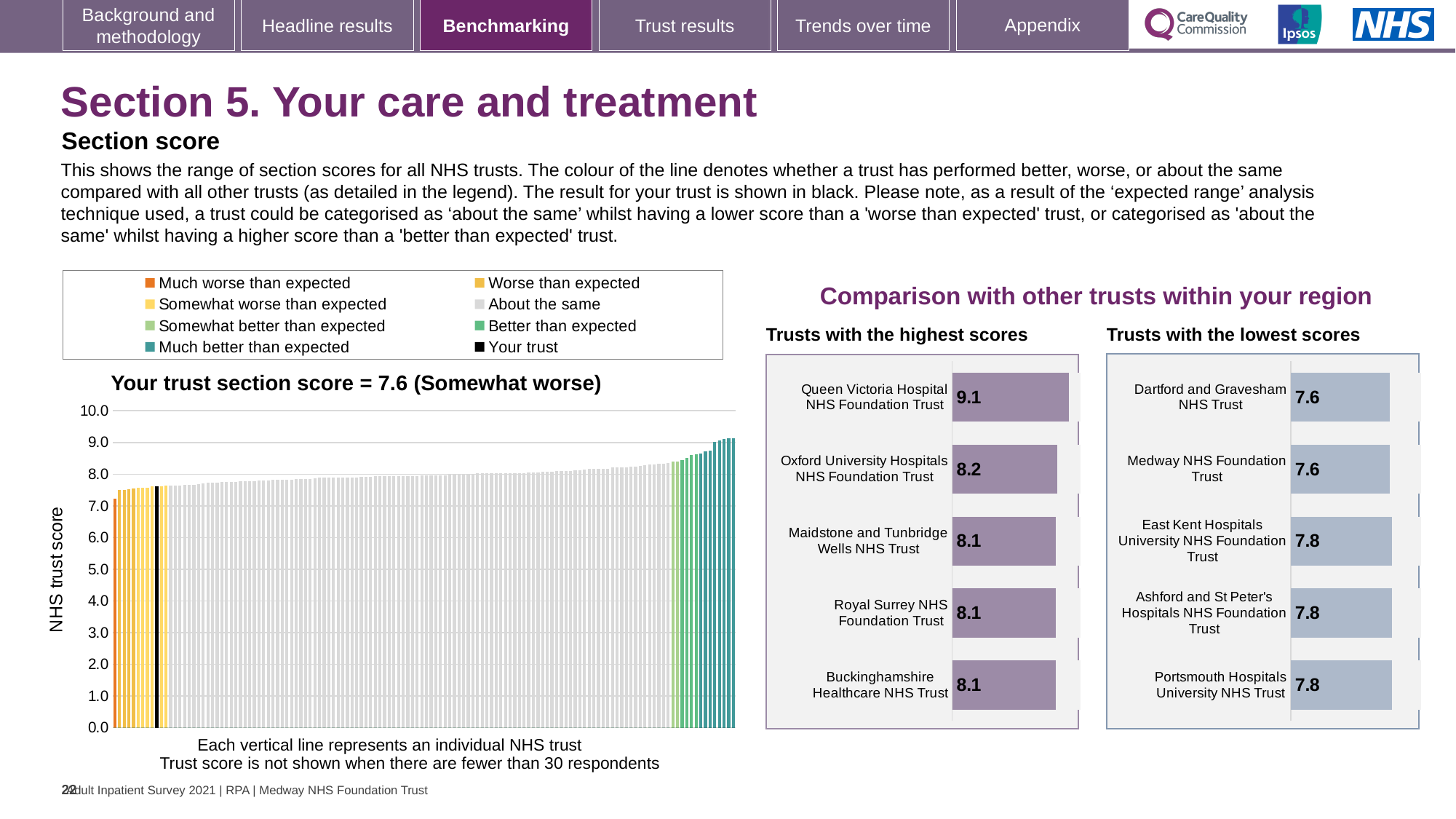
In the 'Trusts with the highest scores' chart, what is the score for Queen Victoria Hospital NHS Foundation Trust? 9.1 According to the title of the chart on the left, what is your trust's section score? 7.6 In the 'Trusts with the highest scores' chart, which trust has the highest score? Queen Victoria Hospital NHS Foundation Trust In the 'Trusts with the lowest scores' chart, what is the score for East Kent Hospitals University NHS Foundation Trust? 7.8 In the 'Trusts with the lowest scores' chart, what is the difference between the scores of East Kent Hospitals University NHS Foundation Trust and Dartford and Gravesham NHS Trust? 0.2 In the 'Trusts with the highest scores' chart, what is the score for Oxford University Hospitals NHS Foundation Trust? 8.2 What kind of chart is the 'Your trust section score' chart on the left of the slide? Bar chart How many trusts are shown in the 'Trusts with the highest scores' chart? 5 In the 'Your trust section score' chart, do the bar values rise or fall from left to right along the x axis? Rise In the 'Trusts with the lowest scores' chart, what is the score for Dartford and Gravesham NHS Trust? 7.6 In the 'Trusts with the highest scores' chart, what is the difference between the scores of Queen Victoria Hospital NHS Foundation Trust and Oxford University Hospitals NHS Foundation Trust? 0.9 In the 'Trusts with the lowest scores' chart, which has the larger score: Portsmouth Hospitals University NHS Trust or Medway NHS Foundation Trust? Portsmouth Hospitals University NHS Trust